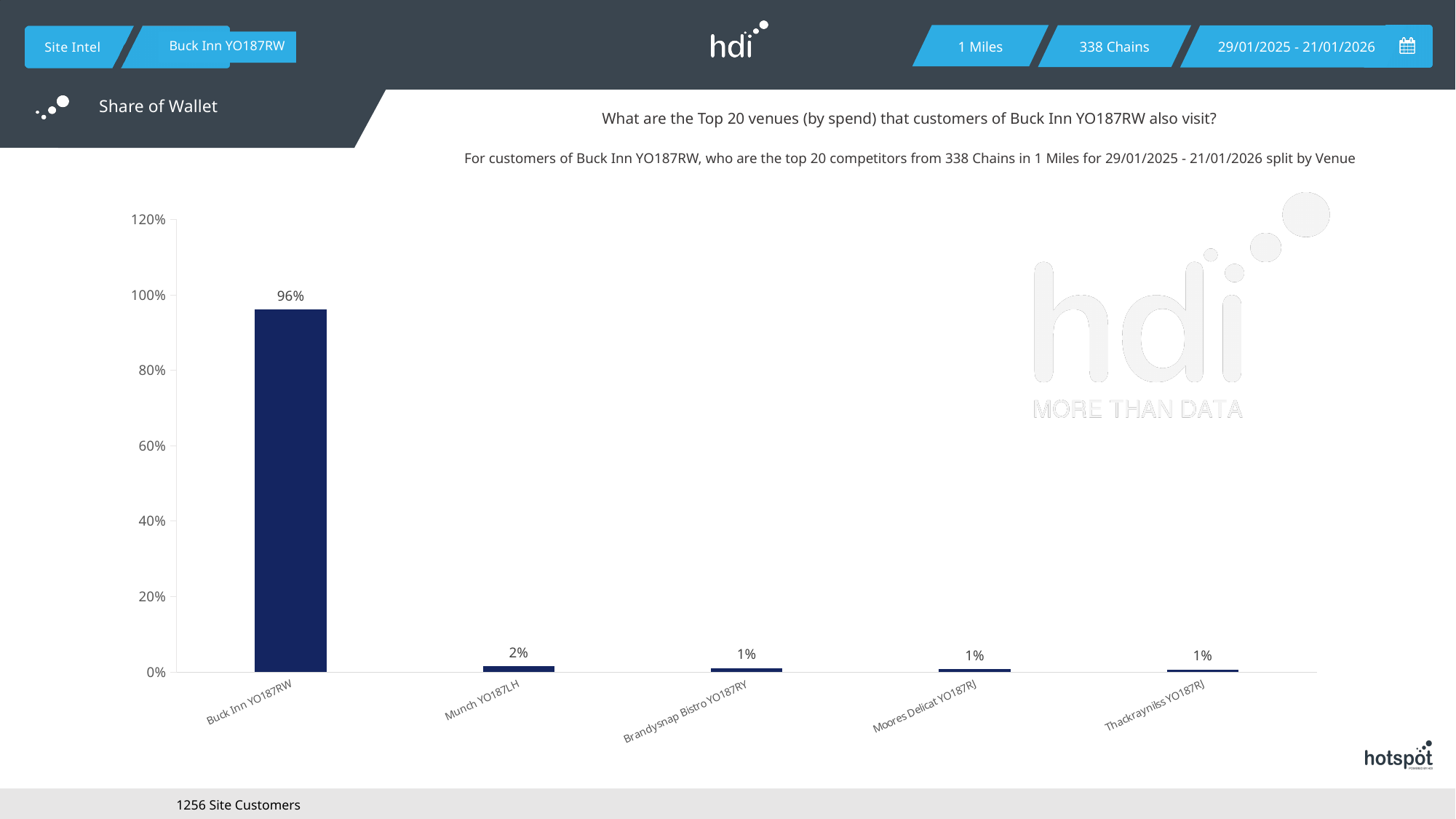
Which is larger, the value for Munch YO187LH or the value for Moores Delicat YO187RJ? Munch YO187LH What is the value for Thackraynilss YO187RJ? 1% Which venue has the highest value? Buck Inn YO187RW What kind of chart is shown on the slide? bar chart What is the value for Brandysnap Bistro YO187RY? 1% What is the difference between the values for Buck Inn YO187RW and Munch YO187LH? 94% What is the highest value shown on the y axis? 120% What is the value for Buck Inn YO187RW? 96% How many venues are shown on the chart? 5 What is the value for Munch YO187LH? 2% How many site customers are stated at the bottom of the slide? 1256 Is the value for Buck Inn YO187RW greater or less than 80%? greater